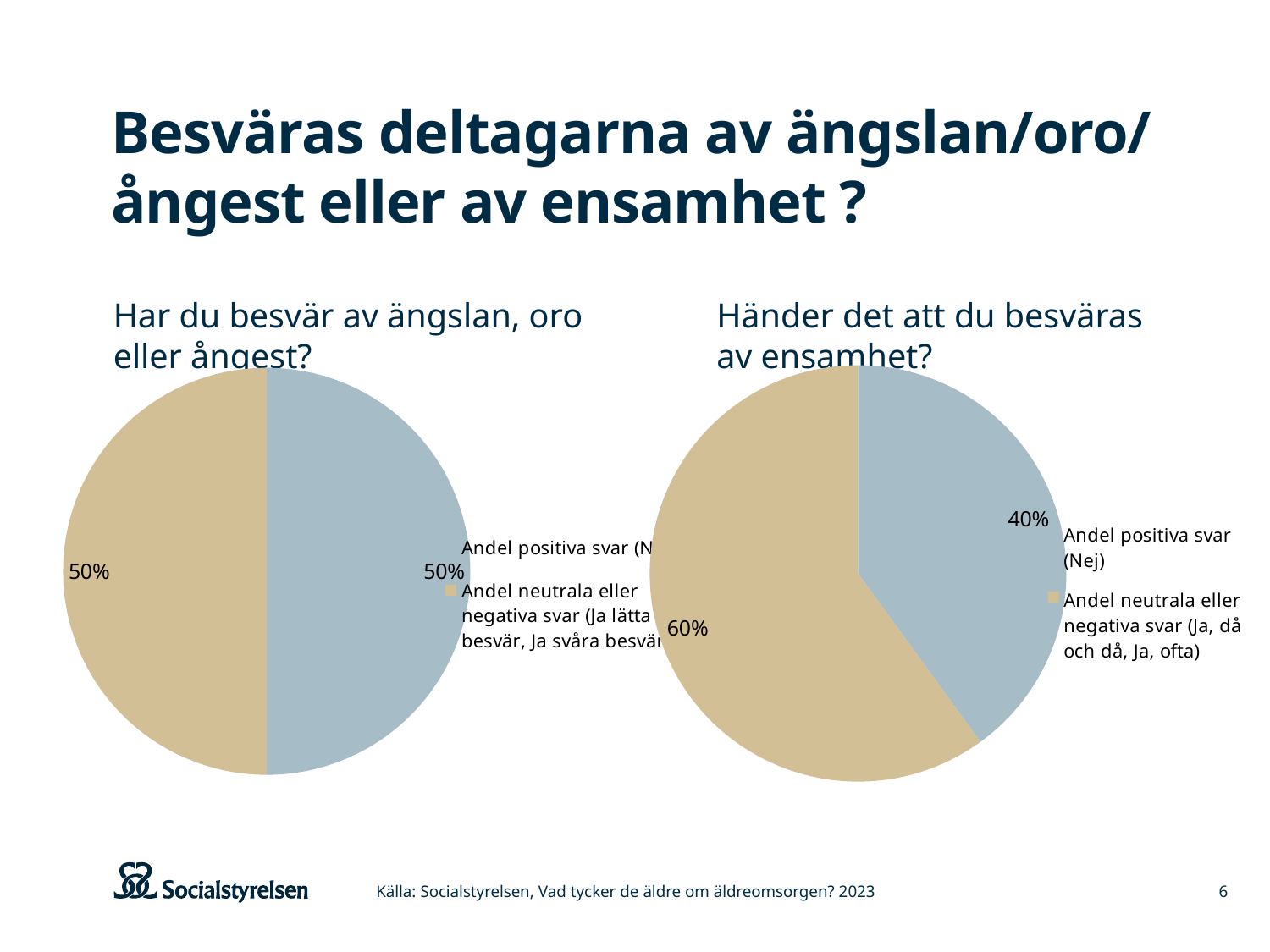
In the chart 'Händer det att du besväras av ensamhet?', what share is 'Andel positiva svar (Nej)'? 40% What is the title of the pie chart on the left of the slide? Har du besvär av ängslan, oro eller ångest? In the chart 'Händer det att du besväras av ensamhet?', what is the difference in percentage points between the neutral/negative slice and the positive slice? 20 percentage points In the chart 'Händer det att du besväras av ensamhet?', is the share of positive answers (Nej) greater or less than 50%? less In the chart 'Händer det att du besväras av ensamhet?', which slice is the largest? Andel neutrala eller negativa svar (Ja, då och då, Ja, ofta) In the chart 'Händer det att du besväras av ensamhet?', which slice is larger: 'Andel positiva svar (Nej)' or 'Andel neutrala eller negativa svar'? Andel neutrala eller negativa svar In the chart 'Händer det att du besväras av ensamhet?', what share is 'Andel neutrala eller negativa svar (Ja, då och då, Ja, ofta)'? 60% How many slices does the chart 'Har du besvär av ängslan, oro eller ångest?' have? 2 In the chart 'Händer det att du besväras av ensamhet?', which slice is the smallest? Andel positiva svar (Nej) What kind of chart is used for 'Händer det att du besväras av ensamhet?'? Pie chart How many entries does the legend of the chart 'Händer det att du besväras av ensamhet?' list? 2 In the chart 'Har du besvär av ängslan, oro eller ångest?', what share is shown for the neutral or negative answers? 50%